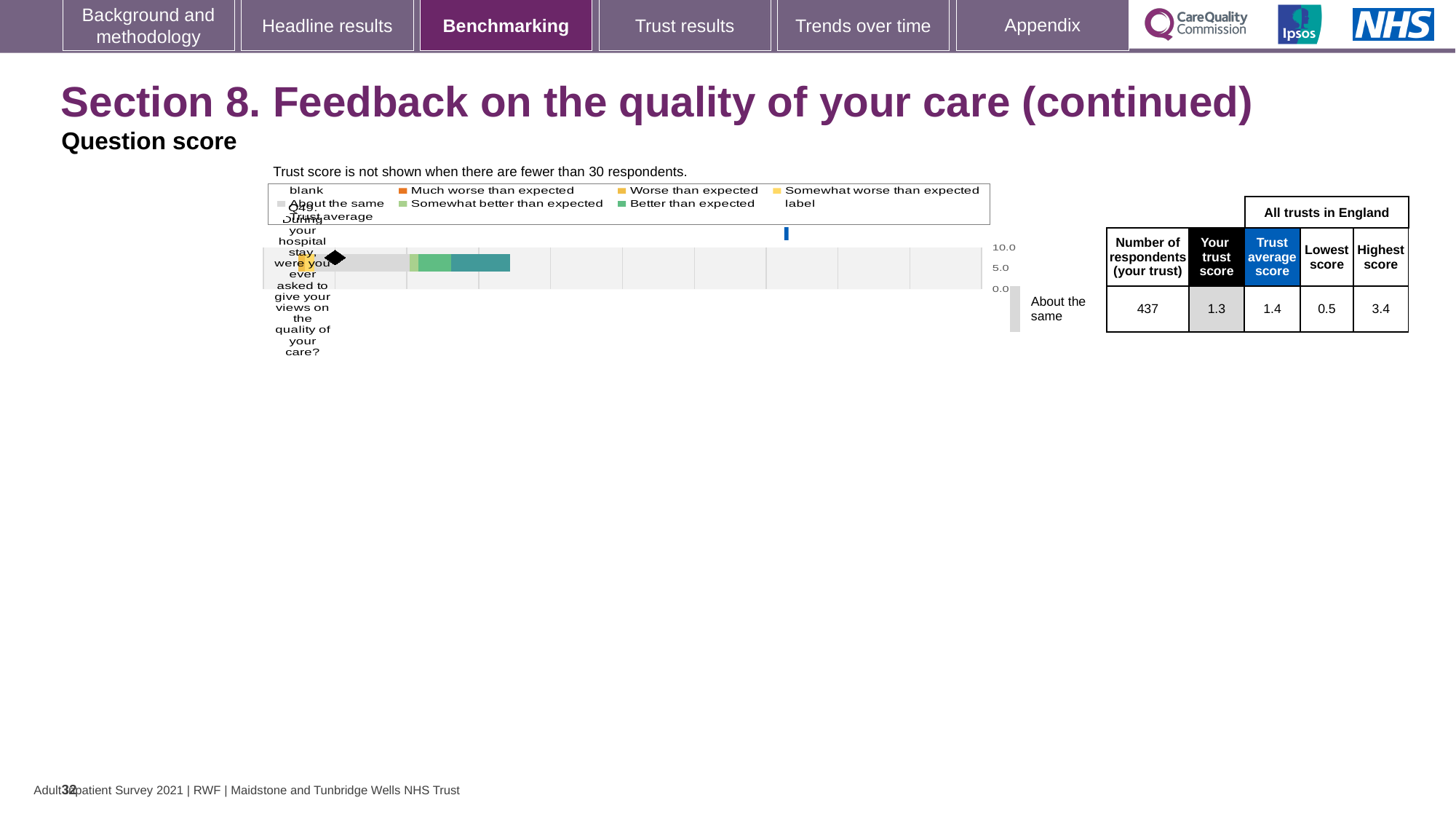
Which benchmark category is the trust's Q49 result placed in? About the same What kind of chart is used to show the Q49 benchmarking result? bar chart What is the highest score across all trusts in England for Q49? 3.4 What is the trust's score for Q49 (were you ever asked to give your views on the quality of your care)? 1.3 What is the lowest score across all trusts in England for Q49? 0.5 How many survey questions are plotted in the chart? 1 What is the trust average score for Q49? 1.4 Which is larger for Q49, the trust's score or the trust average score? trust average score What is the difference between the highest and lowest scores across all trusts in England for Q49? 2.9 Which question number is plotted in the chart? Q49 How many respondents from the trust answered Q49? 437 What colour represents 'Much worse than expected' in the chart legend? orange